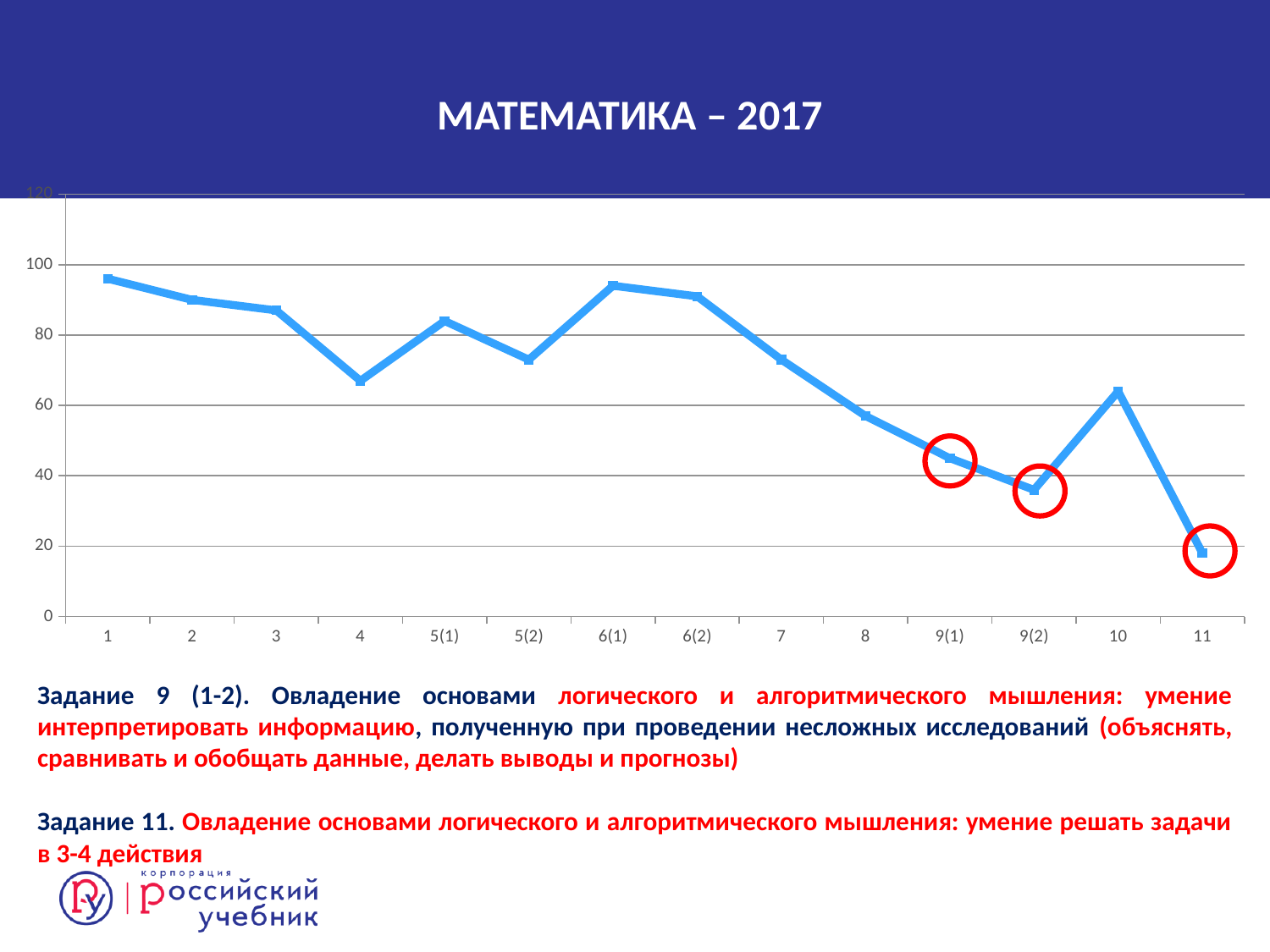
Is the value for category 1 greater or less than 80? greater Is the value for category 4 greater or less than 80? less Is the value for category 9(2) greater or less than 40? less Which has the larger value, category 7 or category 8? 7 What is the title of the slide containing the chart? МАТЕМАТИКА – 2017 Overall, do the values rise or fall from category 1 to category 11? fall What kind of chart is shown on the slide? line chart Which has the larger value, category 6(1) or category 5(2)? 6(1) How many categories are shown on the x axis of the chart? 14 Which category has the lowest value on the chart? 11